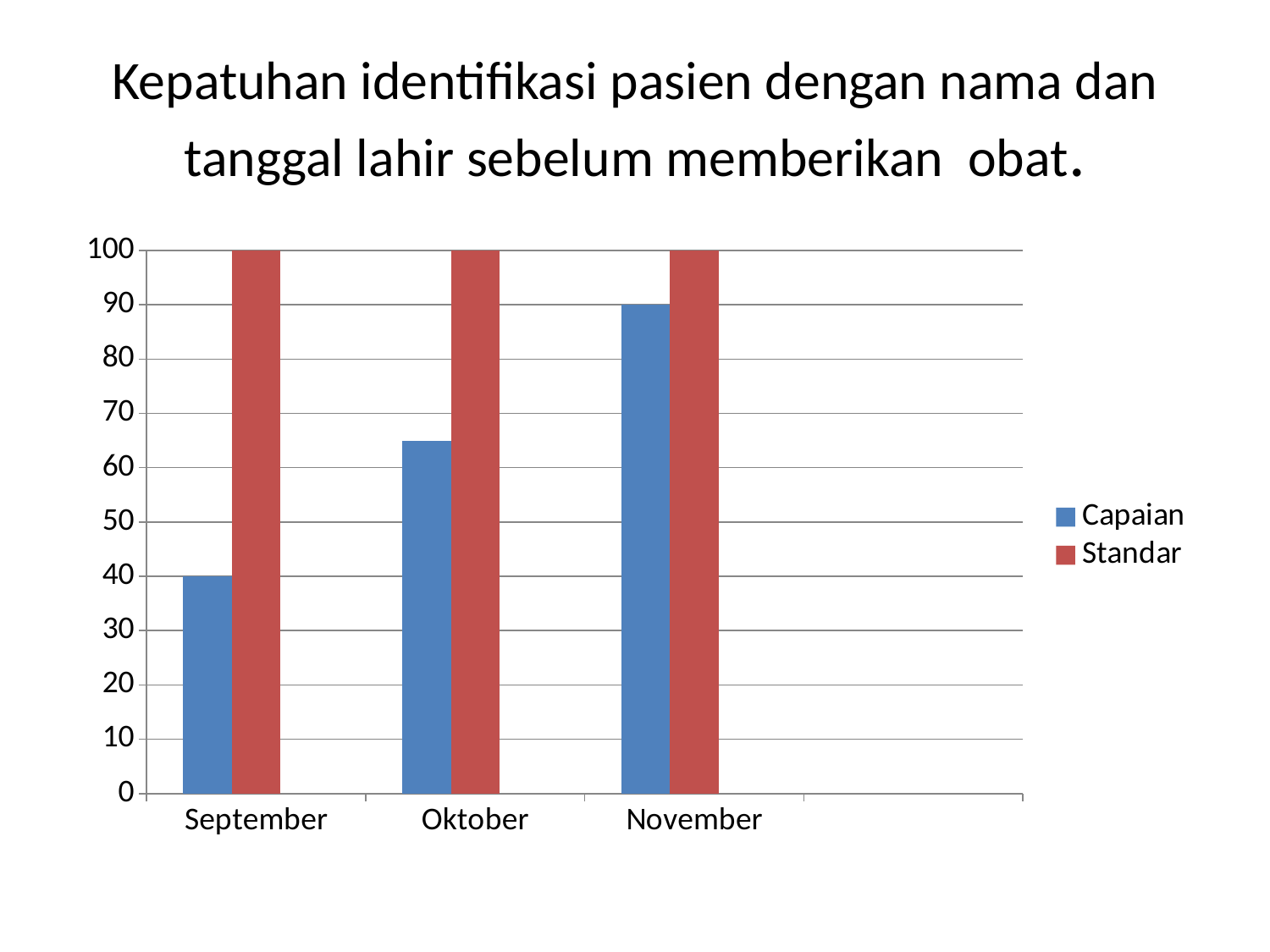
Which series is shown in red in the legend? Standar Do the Capaian values rise or fall from September to November? rise Is the Capaian value for Oktober greater or less than 60? greater What is the difference between the Capaian values for November and September? 50 What is the Capaian value for September? 40 How many series does the legend list? 2 What kind of chart is shown on the slide? bar chart What is the Capaian value for November? 90 Which month has the highest Capaian value? November What is the Standar value for Oktober? 100 Which month has the lowest Capaian value? September How many months are shown on the x axis? 3